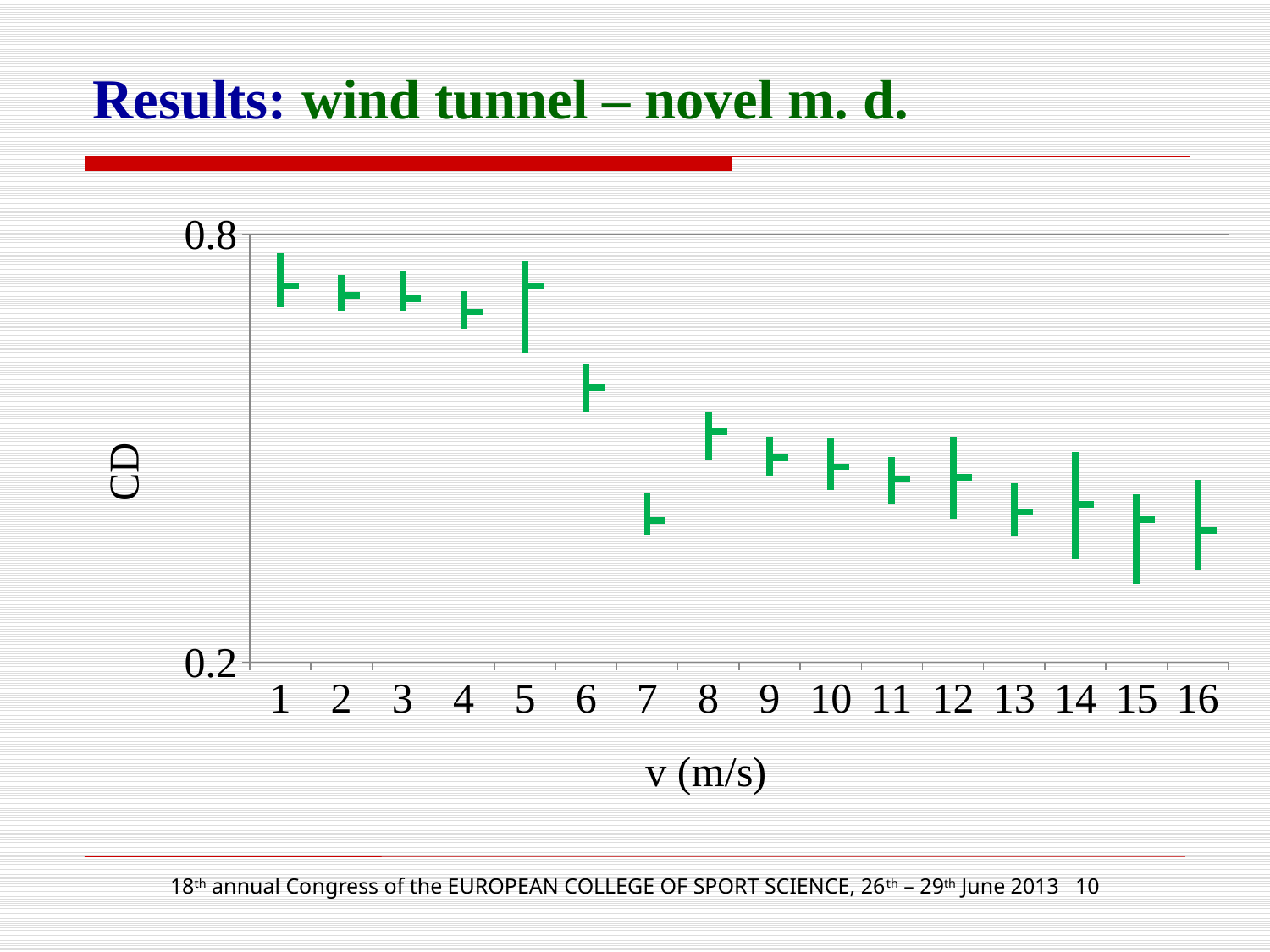
Which has the larger CD value, v = 1 m/s or v = 16 m/s? v = 1 m/s Which has the larger CD value, v = 6 m/s or v = 7 m/s? v = 6 m/s Is the CD value for v = 16 m/s greater or less than 0.2? greater Is the CD value for v = 1 m/s greater or less than 0.8? less What kind of chart is shown on the slide? high-low (stock) chart with mean markers What quantity is plotted on the y axis of the chart? CD What is the label of the x axis of the chart? v (m/s) Which has the larger CD value, v = 7 m/s or v = 8 m/s? v = 8 m/s Is the CD value for v = 10 m/s greater or less than 0.8? less How many velocity values (x-axis categories) are plotted on the chart? 16 Do the CD values generally rise or fall as v increases from 1 to 16 m/s? fall